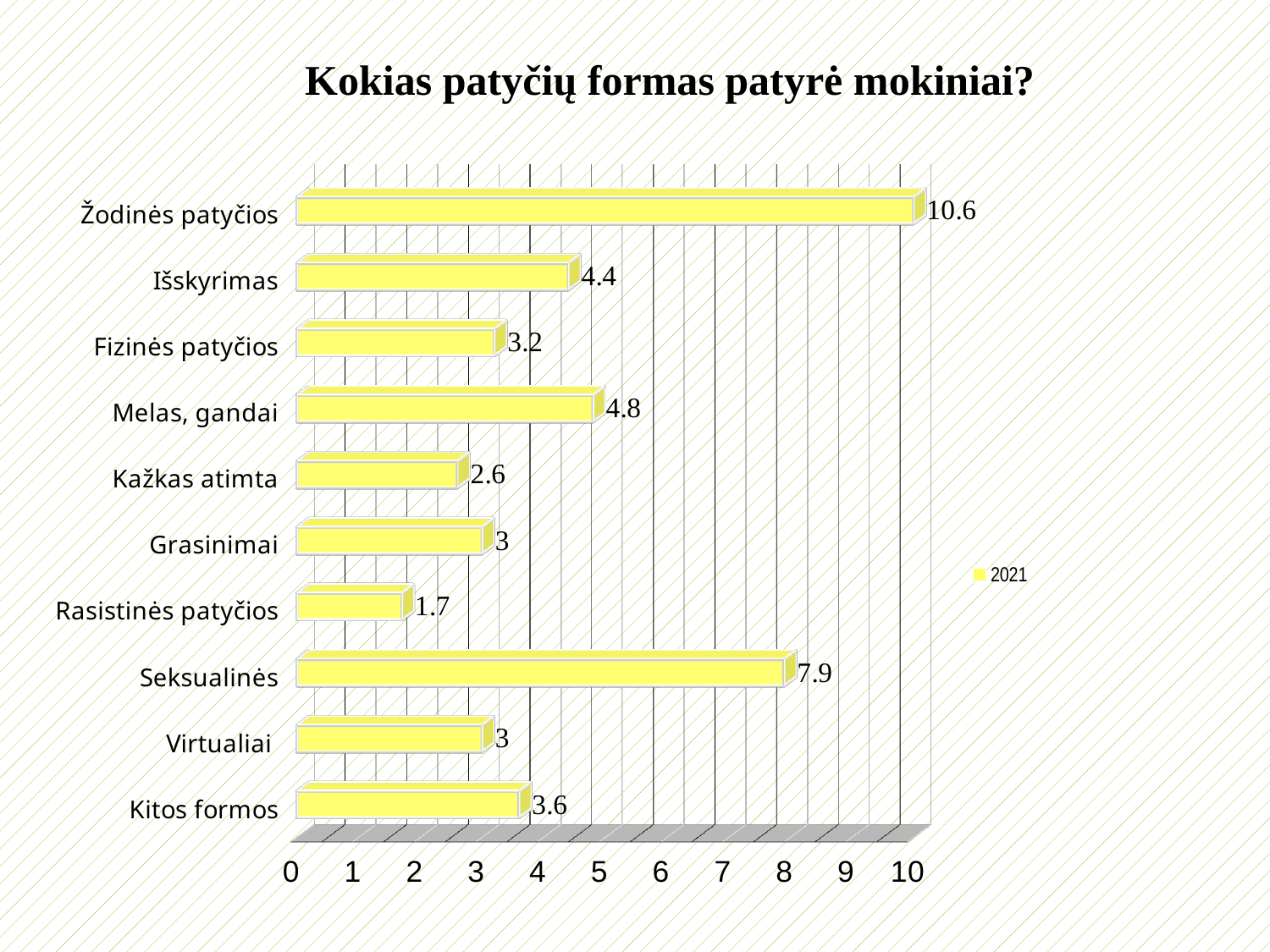
Is the value for Seksualinės greater or less than 5? greater What is the value for Žodinės patyčios? 10.6 What is the value for Rasistinės patyčios? 1.7 How many categories are shown in the chart? 10 What is the value for Kitos formos? 3.6 What is the difference between the values for Žodinės patyčios and Seksualinės? 2.7 Which category has the lowest value? Rasistinės patyčios Which category has the highest value? Žodinės patyčios What kind of chart is shown on the slide? Bar chart What is the value for Seksualinės? 7.9 Which is larger, the value for Išskyrimas or the value for Melas, gandai? Melas, gandai What year does the legend entry show? 2021